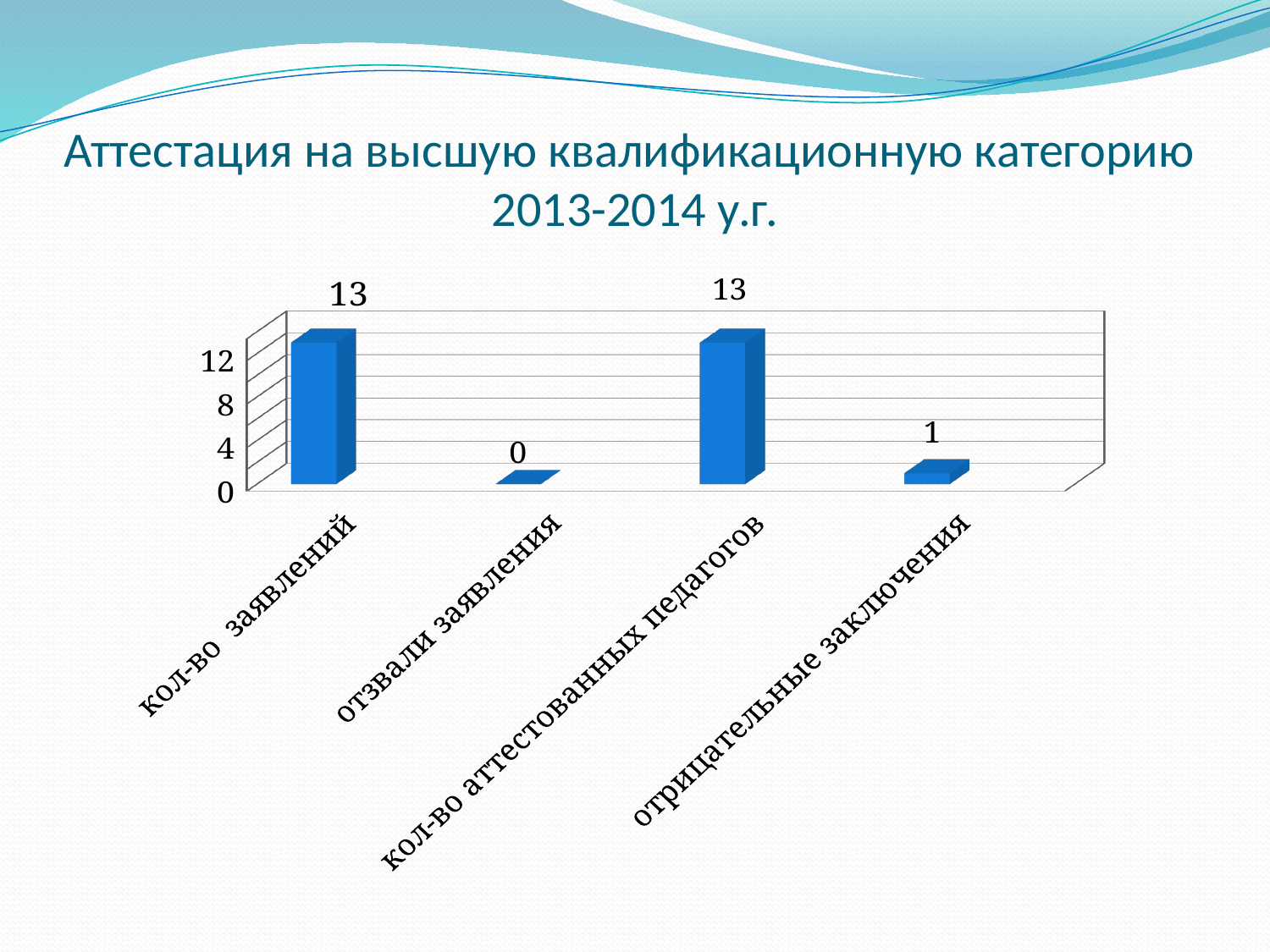
Is the value for «отрицательные заключения» greater or less than 4? less Which is larger: «кол-во заявлений» or «отрицательные заключения»? кол-во заявлений What is the title of the slide? Аттестация на высшую квалификационную категорию 2013-2014 у.г. What is the value for «кол-во заявлений»? 13 How many categories are shown on the chart? 4 What is the value for «отзвали заявления»? 0 What kind of chart is shown on the slide? bar chart Which category has the lowest value? отзвали заявления Is the value for «кол-во заявлений» greater or less than 8? greater What is the value for «отрицательные заключения»? 1 What is the difference between «кол-во аттестованных педагогов» and «отрицательные заключения»? 12 What is the value for «кол-во аттестованных педагогов»? 13